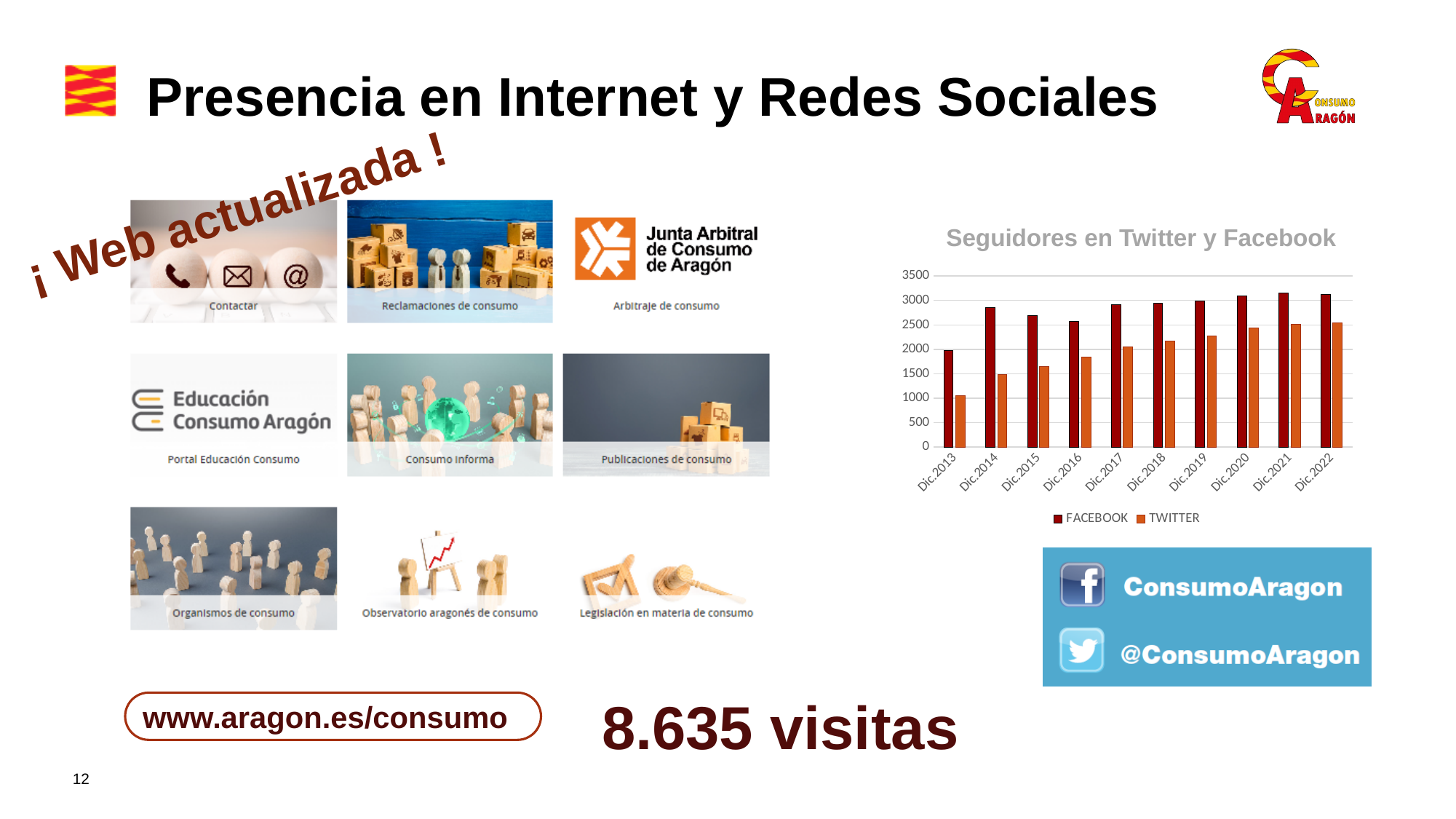
What kind of chart is shown under the title 'Seguidores en Twitter y Facebook'? bar chart In the 'Seguidores en Twitter y Facebook' chart, is the FACEBOOK value for Dic.2014 greater or less than 2500? greater How many series does the legend of the 'Seguidores en Twitter y Facebook' chart list? 2 What is the title of the chart on the right side of the slide? Seguidores en Twitter y Facebook In the 'Seguidores en Twitter y Facebook' chart, is the TWITTER value for Dic.2016 greater or less than 2000? less In the 'Seguidores en Twitter y Facebook' chart, which is larger in Dic.2013, FACEBOOK or TWITTER? FACEBOOK In the 'Seguidores en Twitter y Facebook' chart, is the TWITTER value for Dic.2013 greater or less than 1500? less In the 'Seguidores en Twitter y Facebook' chart, do the TWITTER values rise or fall from Dic.2013 to Dic.2022? rise How many time periods (categories) are shown on the x axis of the 'Seguidores en Twitter y Facebook' chart? 10 In the 'Seguidores en Twitter y Facebook' chart, which period has the lowest TWITTER value? Dic.2013 In the 'Seguidores en Twitter y Facebook' chart, which period has the lowest FACEBOOK value? Dic.2013